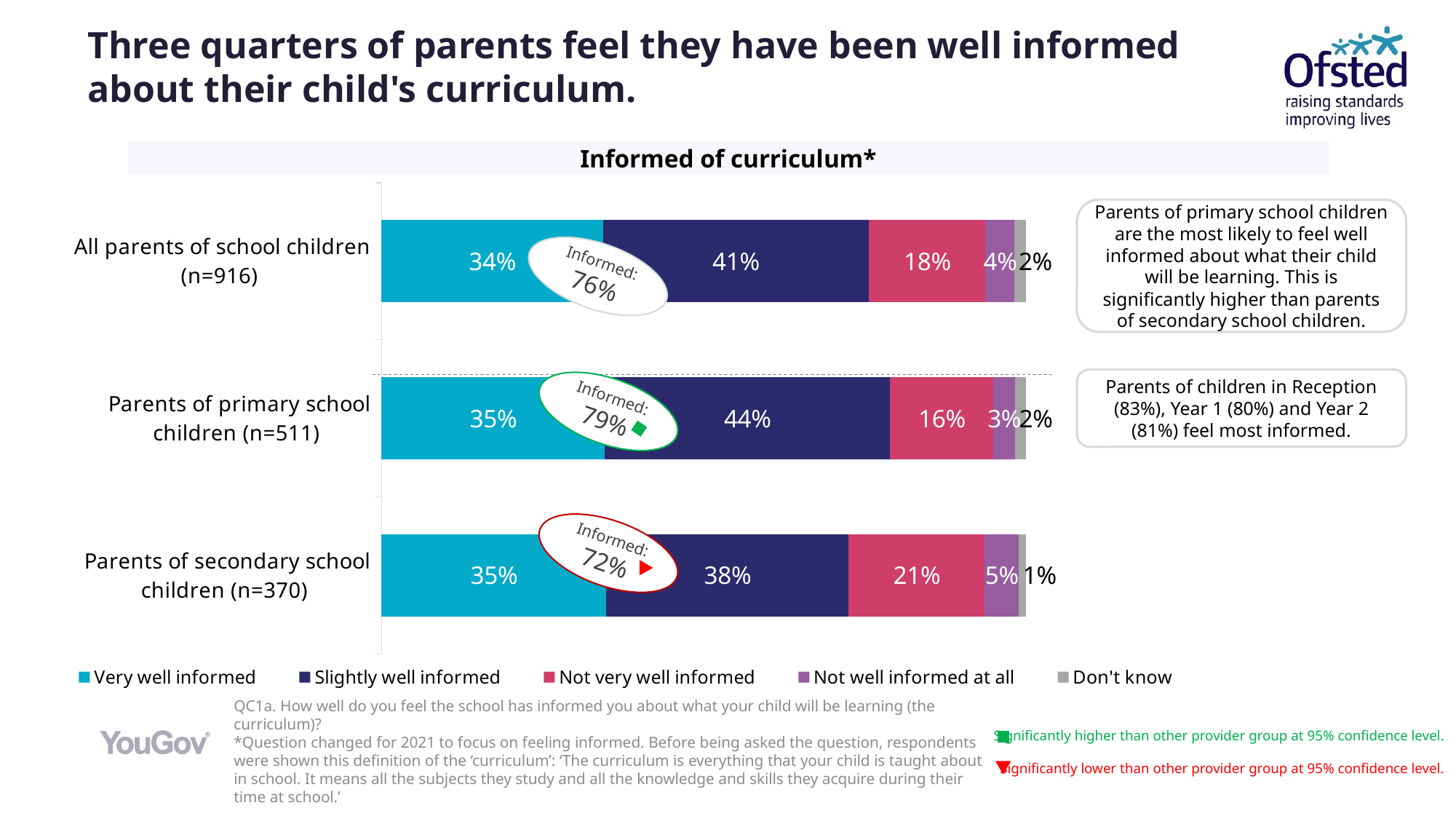
What percentage of all parents of school children (n=916) are 'Very well informed' about the curriculum? 34% Which parent group has the lowest 'Informed' total? Parents of secondary school children (n=370) What percentage of parents of secondary school children (n=370) are 'Not very well informed'? 21% Which is larger: the 'Slightly well informed' share for parents of primary school children or for parents of secondary school children? Parents of primary school children How many series does the legend list? 5 What is the 'Informed' total shown for parents of primary school children? 79% What type of chart is shown on the slide? Stacked bar chart What percentage of parents of primary school children (n=511) are 'Slightly well informed'? 44% What is the difference between the 'Informed' totals for parents of primary school children and parents of secondary school children? 7 percentage points What is the 'Informed' total shown for parents of secondary school children? 72% Which parent group has the highest 'Not very well informed' percentage? Parents of secondary school children (n=370) How many parent groups are shown in the chart? 3